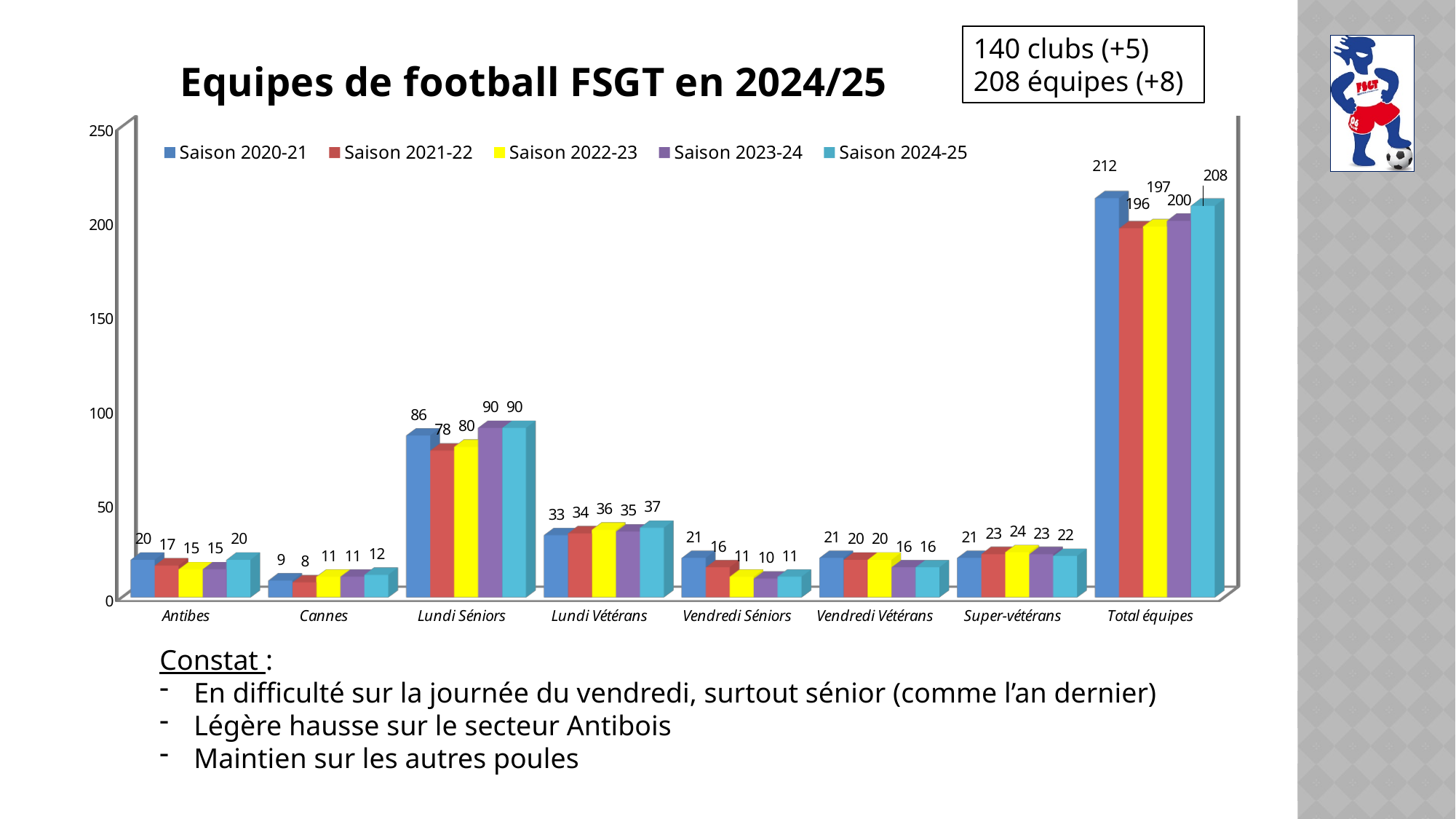
What kind of chart is shown on the slide? Bar chart What is the value for Cannes in Saison 2021-22? 8 What is the value for Total équipes in Saison 2020-21? 212 Which category has the lowest value in Saison 2020-21? Cannes What is the title of the chart? Equipes de football FSGT en 2024/25 What is the value for Lundi Séniors in Saison 2024-25? 90 What is the difference between the Total équipes values for Saison 2024-25 and Saison 2023-24? 8 Which is larger: Antibes in Saison 2024-25 or Super-vétérans in Saison 2024-25? Super-vétérans in Saison 2024-25 What is the value for Vendredi Séniors in Saison 2023-24? 10 How many series does the legend list? 5 How many categories are shown on the x axis? 8 Excluding Total équipes, which category has the highest value in Saison 2024-25? Lundi Séniors